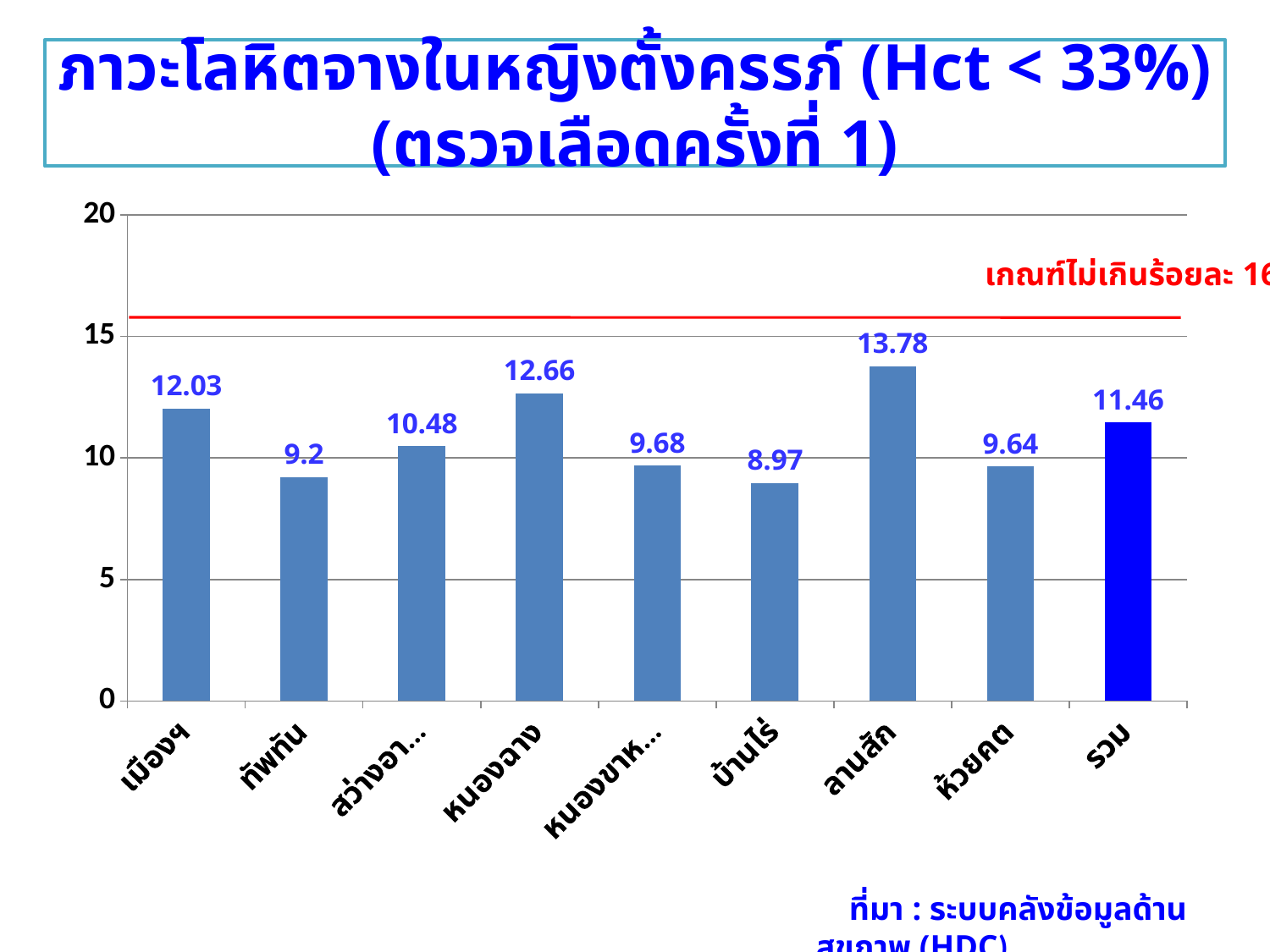
What is the value for ทัพทัน? 9.2 Which is larger, the value for หนองฉาง or the value for เมืองฯ? หนองฉาง What kind of chart is shown on the slide? bar chart What is the difference between the values for เมืองฯ and ทัพทัน? 2.83 What is the difference between the values for ลานสัก and บ้านไร่? 4.81 Which category has the lowest value? บ้านไร่ What is the value for รวม? 11.46 What is the value for ลานสัก? 13.78 How many categories are shown on the x axis? 9 Is the value for ลานสัก greater or less than 15? less Which category has the highest value? ลานสัก What is the value for เมืองฯ? 12.03